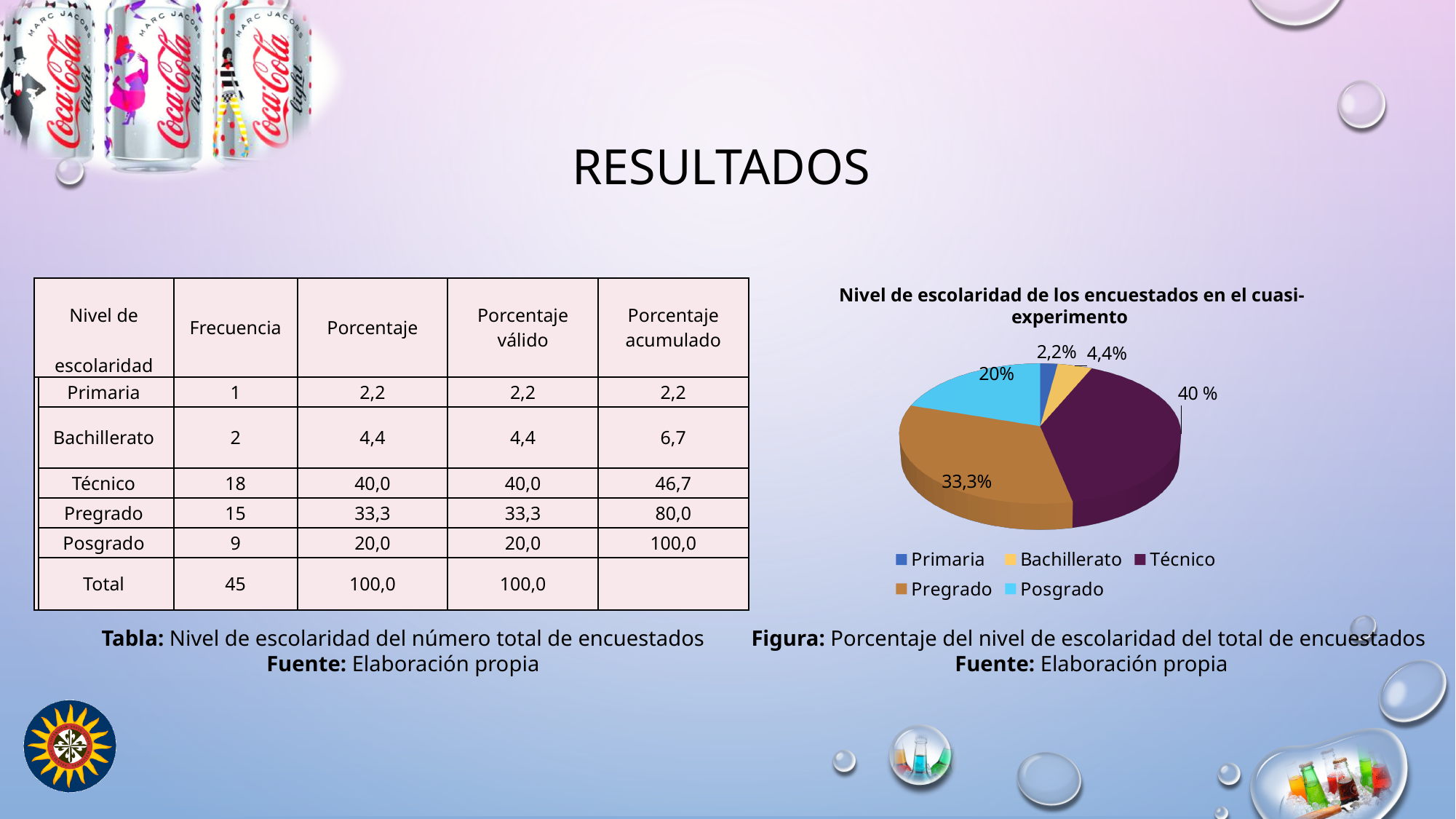
What is the title of the pie chart? Nivel de escolaridad de los encuestados en el cuasi-experimento Which legend entry is shown in light blue in the pie chart? Posgrado How many categories does the legend of the pie chart list? 5 Which category has the largest slice in the pie chart? Técnico What percentage does the pie chart show for Técnico? 40 % What percentage does the pie chart show for Posgrado? 20% What percentage does the pie chart show for Bachillerato? 4,4% Which category has the smallest slice in the pie chart? Primaria Which slice is larger in the pie chart, Pregrado or Posgrado? Pregrado What percentage does the pie chart show for Primaria? 2,2% What type of chart is shown on the slide? pie chart What percentage does the pie chart show for Pregrado? 33,3%